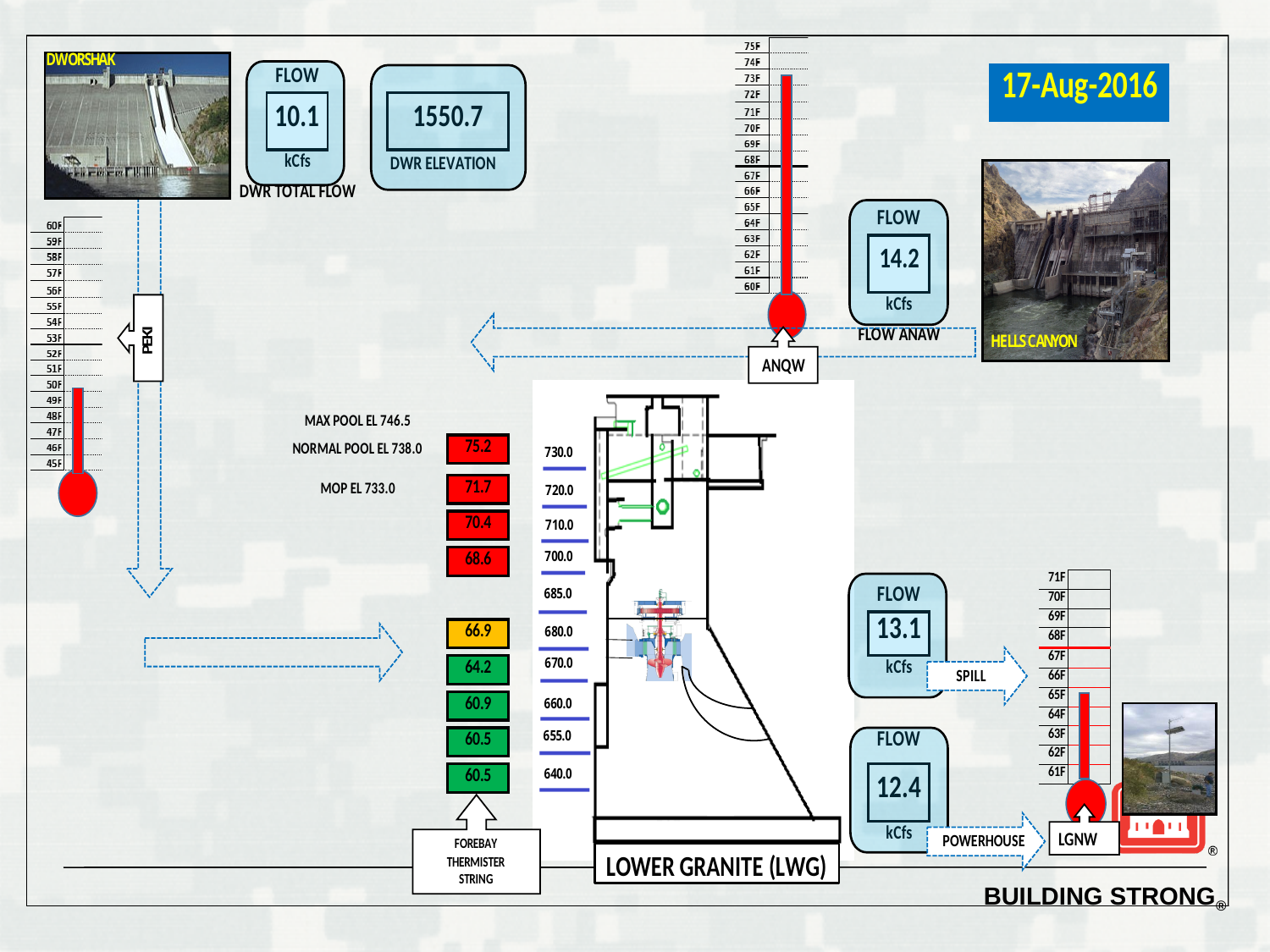
On the ANQW thermometer gauge, is the temperature reading greater or less than 70F? greater On the LGNW thermometer gauge, is the temperature reading greater or less than 68F? less How many temperature readings are shown on the forebay thermister string? 9 Which is larger, the SPILL flow or the POWERHOUSE flow at Lower Granite? SPILL On the forebay thermister string, how many readings are shown in red boxes? 4 On the forebay thermister string, what is the topmost temperature reading shown? 75.2 On the PEKI thermometer gauge, is the temperature reading greater or less than 55F? less On the forebay thermister string, what is the highest temperature reading? 75.2 On the forebay thermister string, what is the difference between the topmost reading (75.2) and the reading directly below it (71.7)? 3.5 On the forebay thermister string, which reading is shown in a yellow box? 66.9 On the forebay thermister string, do the temperature readings rise or fall going from the top of the string to the bottom? fall On the forebay thermister string, what is the bottommost temperature reading shown? 60.5